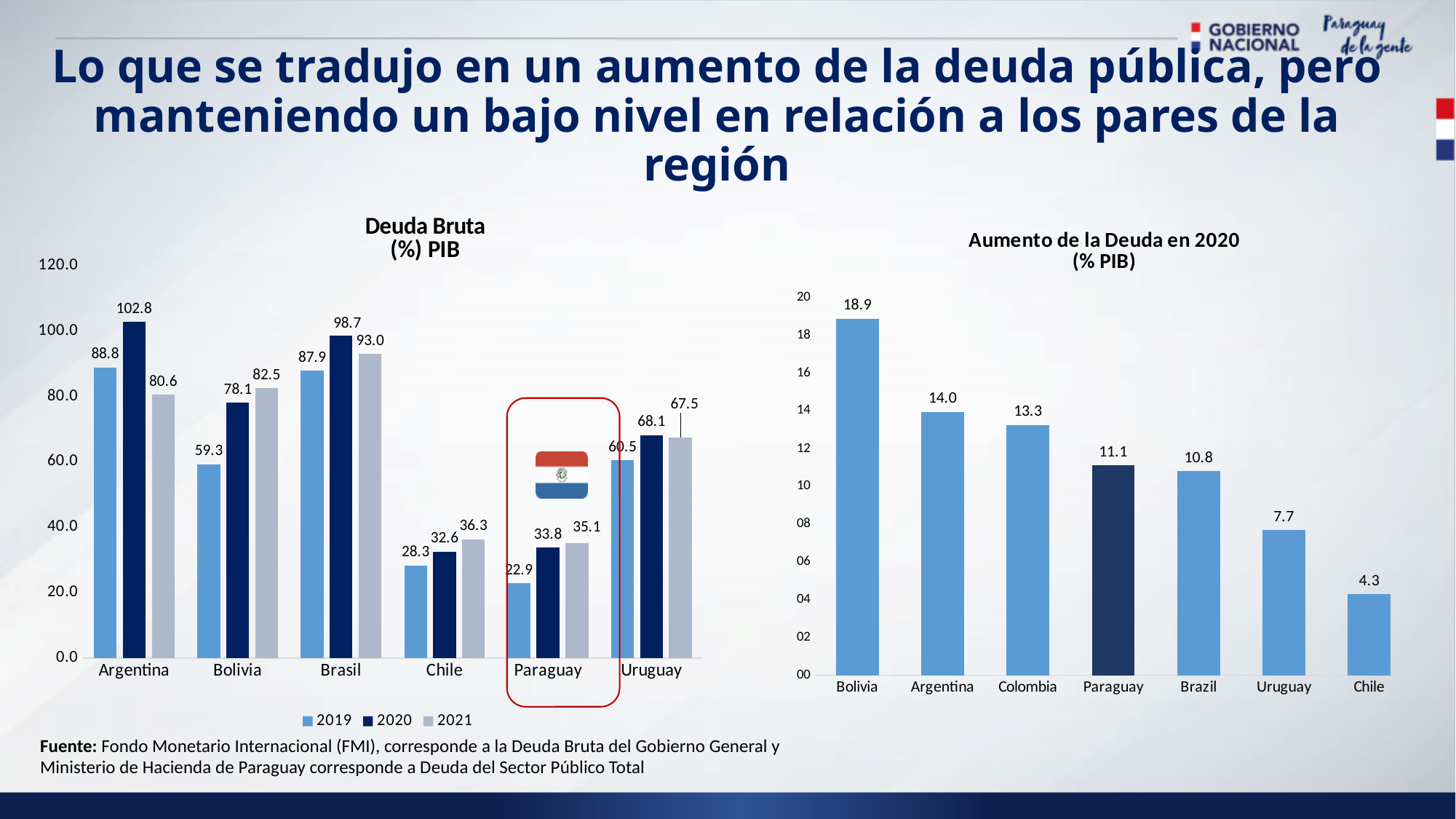
In the 'Deuda Bruta (%) PIB' chart, what is the value for Paraguay in 2019? 22.9 In the 'Deuda Bruta (%) PIB' chart, what is the difference between Brasil's 2021 value and its 2019 value? 5.1 In the 'Aumento de la Deuda en 2020 (% PIB)' chart, what is the difference between Bolivia and Chile? 14.6 What kind of chart is the 'Aumento de la Deuda en 2020 (% PIB)' chart? Bar chart In the 'Aumento de la Deuda en 2020 (% PIB)' chart, which is larger, the value for Paraguay or the value for Brazil? Paraguay In the 'Aumento de la Deuda en 2020 (% PIB)' chart, what is the value for Colombia? 13.3 In the 'Deuda Bruta (%) PIB' chart, how many series does the legend list? 3 In the 'Deuda Bruta (%) PIB' chart, how many countries are shown on the x axis? 6 In the 'Aumento de la Deuda en 2020 (% PIB)' chart, which country has the highest value? Bolivia In the 'Deuda Bruta (%) PIB' chart, what is the value for Argentina in 2020? 102.8 In the 'Deuda Bruta (%) PIB' chart, which country has the lowest value in 2021? Paraguay In the 'Deuda Bruta (%) PIB' chart, which country has the highest value in 2020? Argentina